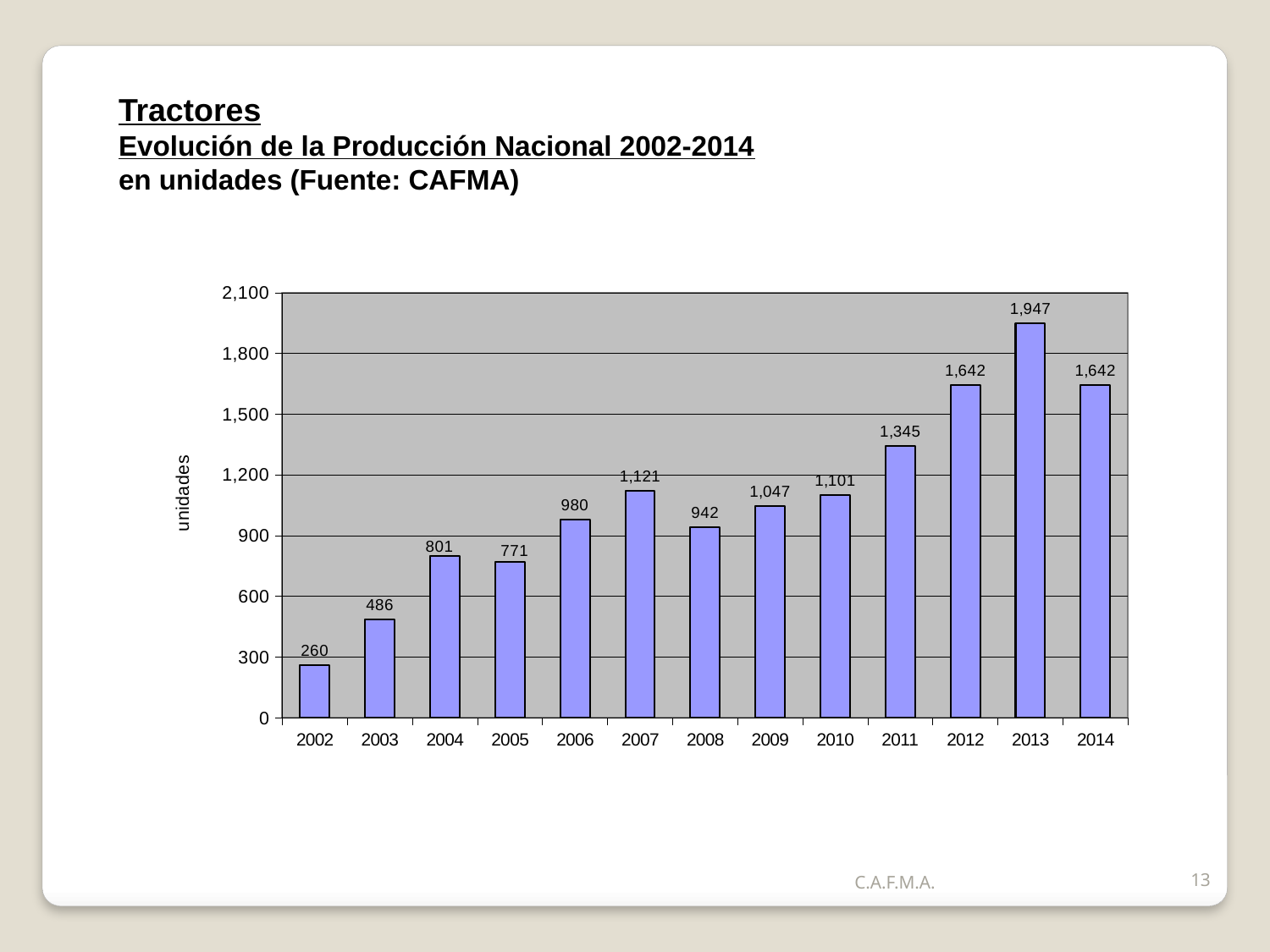
Which year had the highest tractor production? 2013 Is the value for 2010 greater or less than 1,200? less How many years are shown on the x axis? 13 Which year had higher production, 2007 or 2008? 2007 Which year had the lowest tractor production? 2002 What kind of chart is shown on the slide? bar chart What is the difference in production between 2013 and 2012? 305 What was the tractor production in 2011? 1,345 What was the tractor production in 2006? 980 Do the values generally rise or fall from 2002 to 2013? rise What is the label on the y axis? unidades What is the difference in production between 2003 and 2002? 226